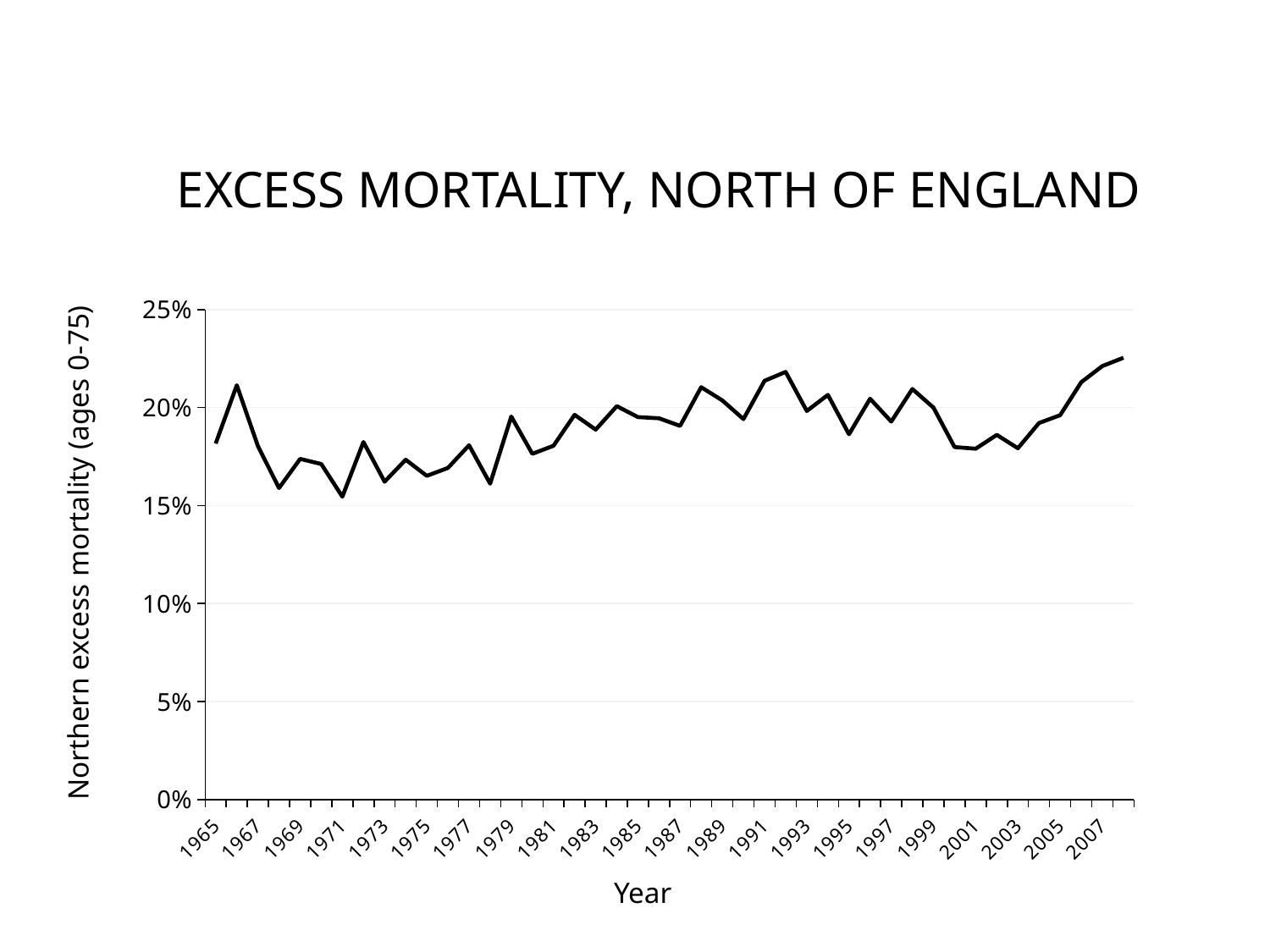
Is the value for 1978 greater or less than 20%? less What is the label on the vertical axis of the chart? Northern excess mortality (ages 0-75) What kind of chart is shown on the slide? line chart What is the title of the chart? EXCESS MORTALITY, NORTH OF ENGLAND Which is larger, the value for 1971 or the value for 1992? 1992 Is the value for 2001 greater or less than 20%? less Which is larger, the value for 1966 or the value for 1968? 1966 Which year has the highest excess mortality value on the chart? 2008 Is the value for 1966 greater or less than 20%? greater Does the line rise or fall between 2003 and 2008? rise